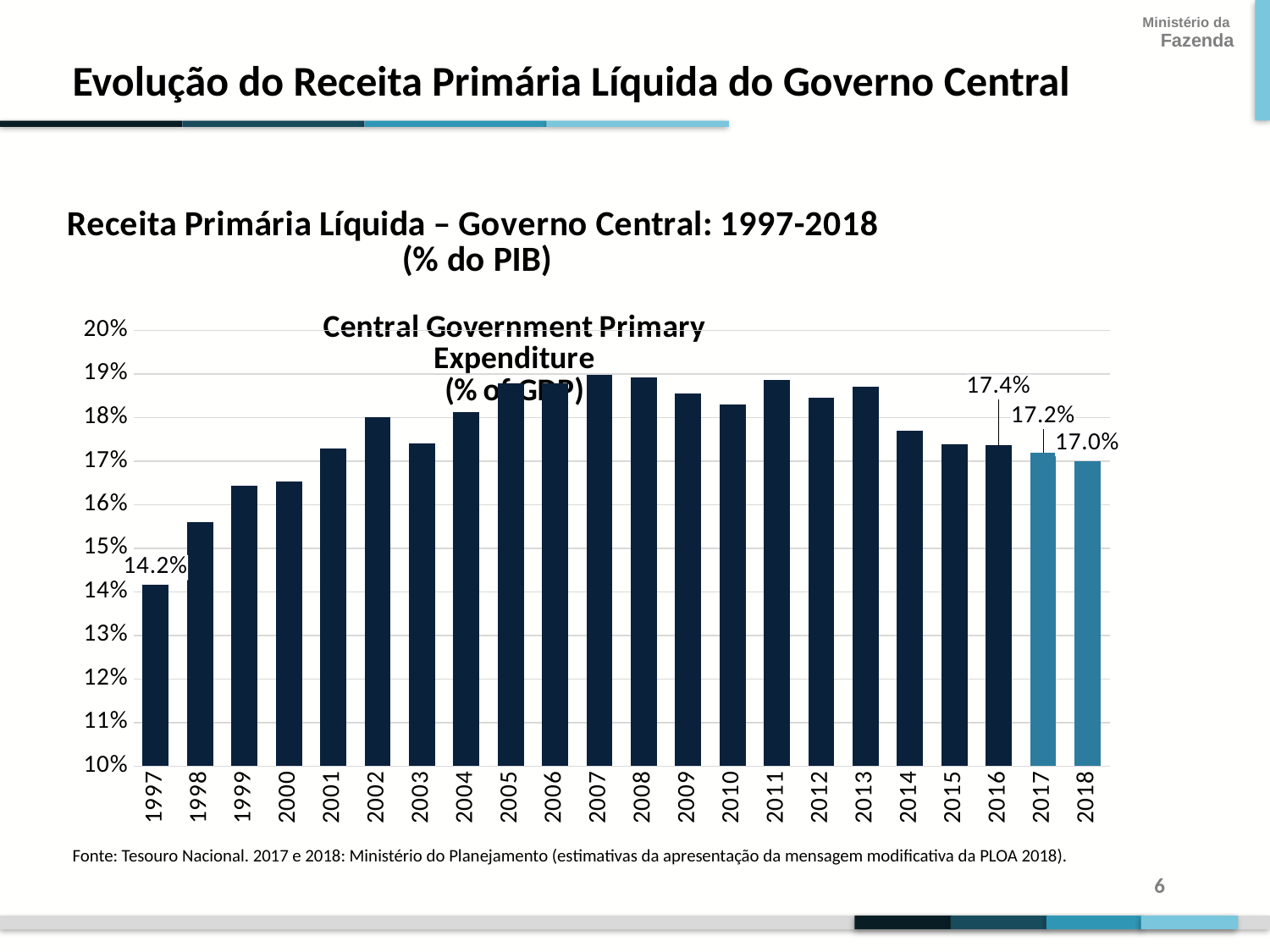
Is the value for 1998 greater or less than 15%? greater Which is larger, the value for 2017 or the value for 2018? 2017 Do the values rise or fall from 2013 to 2018? Fall What is the value for 2018? 17.0% What kind of chart is shown on the slide? Bar chart Is the value for 2014 greater or less than 18%? less What is the difference between the values for 2016 and 2017? 0.2 percentage points Which year has the lowest value? 1997 What is the value for 2017? 17.2% What is the value for 1997? 14.2% What is the value for 2016? 17.4% How many years are shown on the x axis? 22